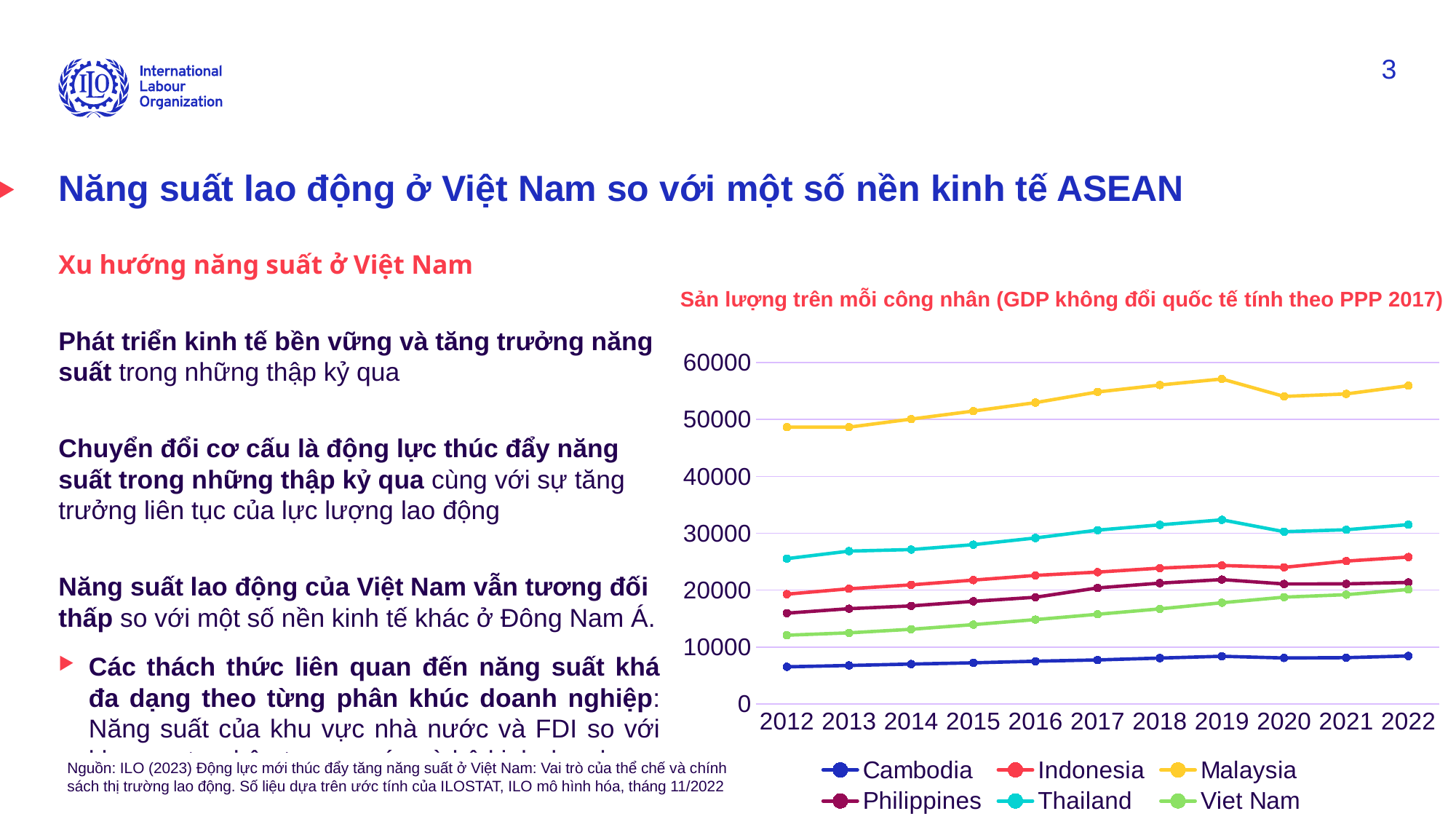
How many series does the chart legend list? 6 What kind of chart is shown on the slide? Line chart Is the value for Thailand in 2019 greater or less than 30000? greater Which country has the lowest output per worker across the whole period shown? Cambodia In 2022, which is larger: the value for Thailand or the value for Indonesia? Thailand Is the value for Cambodia in 2022 greater or less than 10000? less Is the value for Indonesia in 2022 greater or less than 20000? greater What is the title of the chart? Sản lượng trên mỗi công nhân (GDP không đổi quốc tế tính theo PPP 2017) How many years are shown along the x axis of the chart? 11 Does the value for Viet Nam rise or fall from 2012 to 2022? Rise Which country has the highest output per worker across the whole period shown? Malaysia